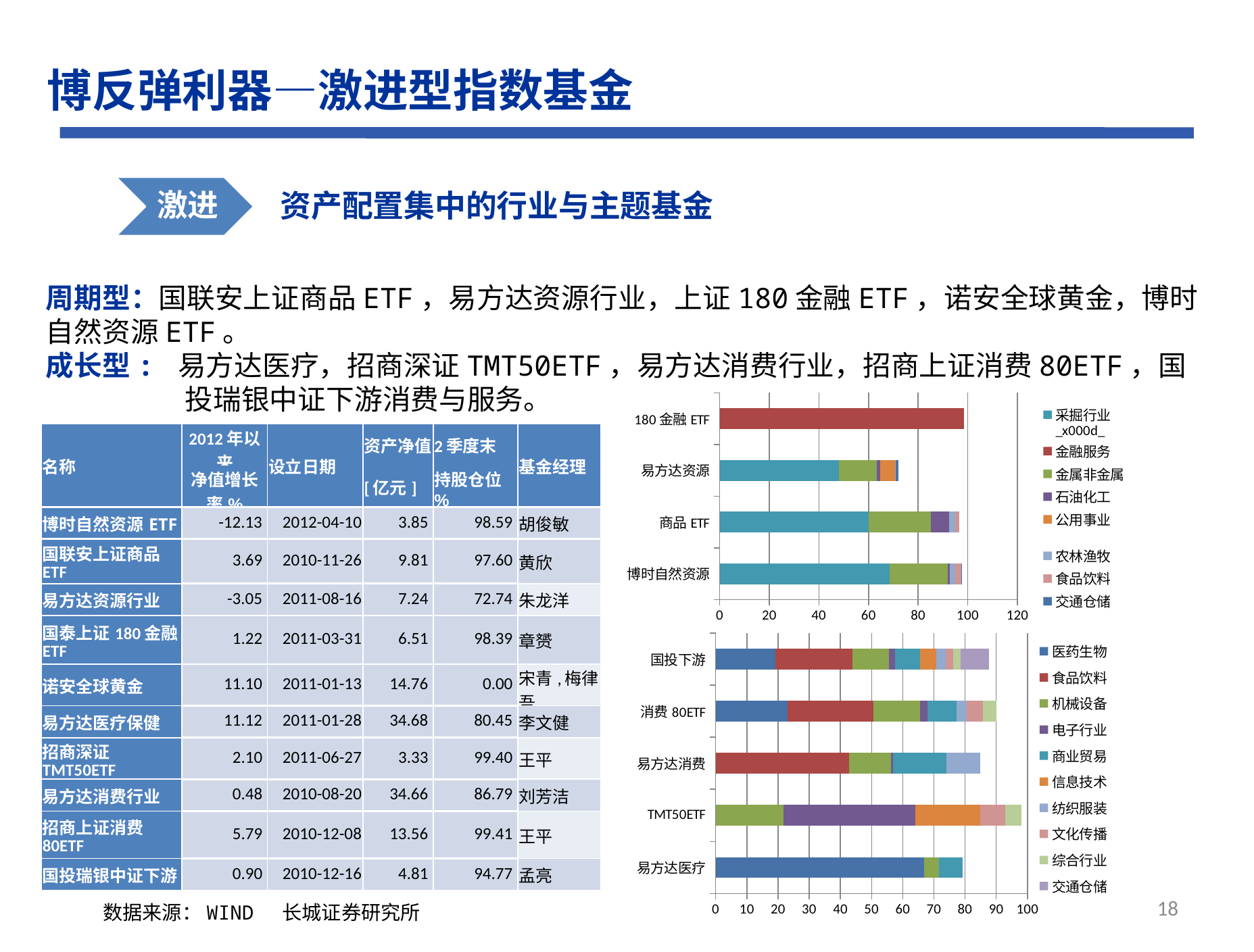
How many series does the legend of the upper chart on the right list? 8 In the upper chart on the right, which fund has the lowest total bar length? 易方达资源 How many categories (funds) does the upper chart on the right show? 4 How many series does the legend of the lower chart on the right list? 10 In the lower chart on the right, is the total value for 易方达消费 greater or less than 90? less What kind of chart is the upper chart on the right (with 180 金融 ETF)? stacked bar chart In the upper chart on the right, is the total value for 180 金融 ETF greater or less than 80? greater In the upper chart on the right, which single series makes up the entire bar for 180 金融 ETF? 金融服务 How many categories (funds) does the lower chart on the right show? 5 In the upper chart on the right, is the total value for 易方达资源 greater or less than 80? less In the upper chart on the right, which bar is longer: 180 金融 ETF or 易方达资源? 180 金融 ETF In the lower chart on the right, which fund has the longest total bar? TMT50ETF